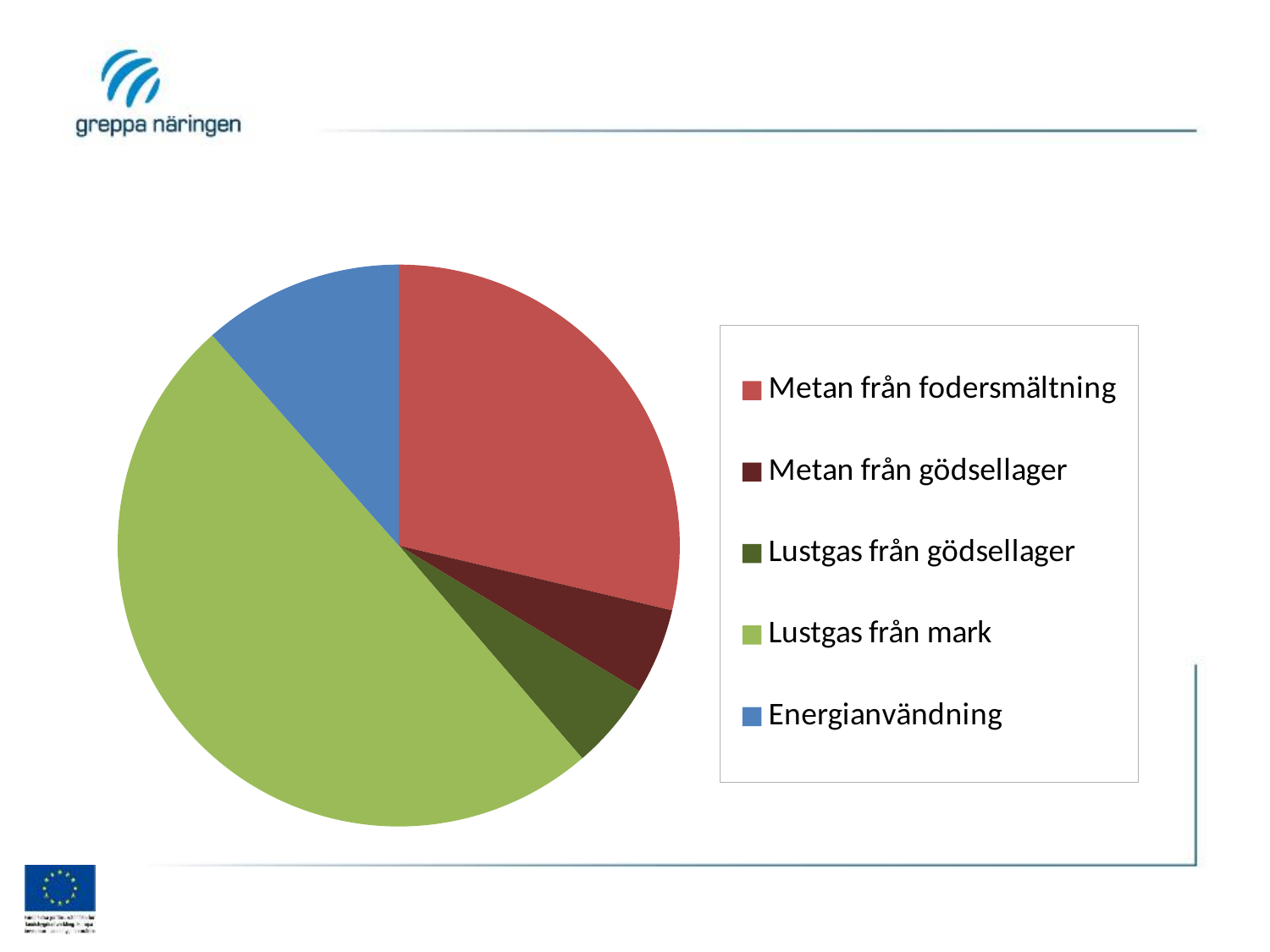
Which slice is larger, Lustgas från mark or Metan från fodersmältning? Lustgas från mark How many entries does the legend of the pie chart list? 5 Which category has the largest slice in the pie chart? Lustgas från mark Which slice is larger, Metan från fodersmältning or Energianvändning? Metan från fodersmältning Which slice is larger, Energianvändning or Lustgas från gödsellager? Energianvändning What kind of chart is shown on the slide? pie chart How many slices does the pie chart have? 5 Which category is shown in blue in the pie chart? Energianvändning What colour is the slice for Lustgas från mark? light green